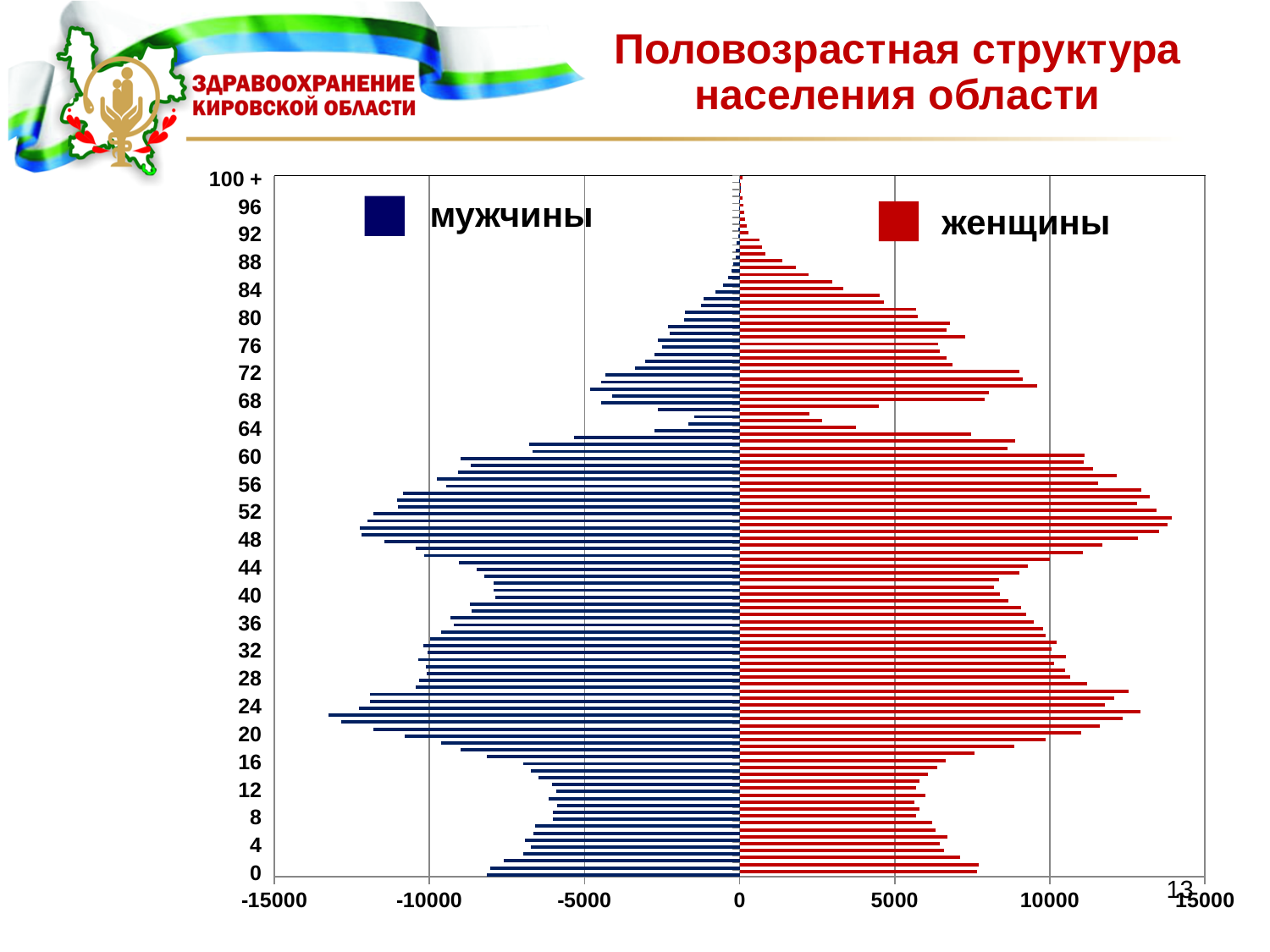
What kind of chart is shown on the slide? bar chart How many series does the legend list? 2 Is the value for женщины at age 40 greater or less than 5000? greater Ignoring the sign, is the value for мужчины at age 72 greater or less than 5000? less Is the value for женщины at age 52 greater or less than 10000? greater What are the two series named in the legend? мужчины, женщины At age 68, which series has the larger value, мужчины or женщины? женщины What is the title of the chart? Половозрастная структура населения области At age 80, which series has the larger value, мужчины or женщины? женщины